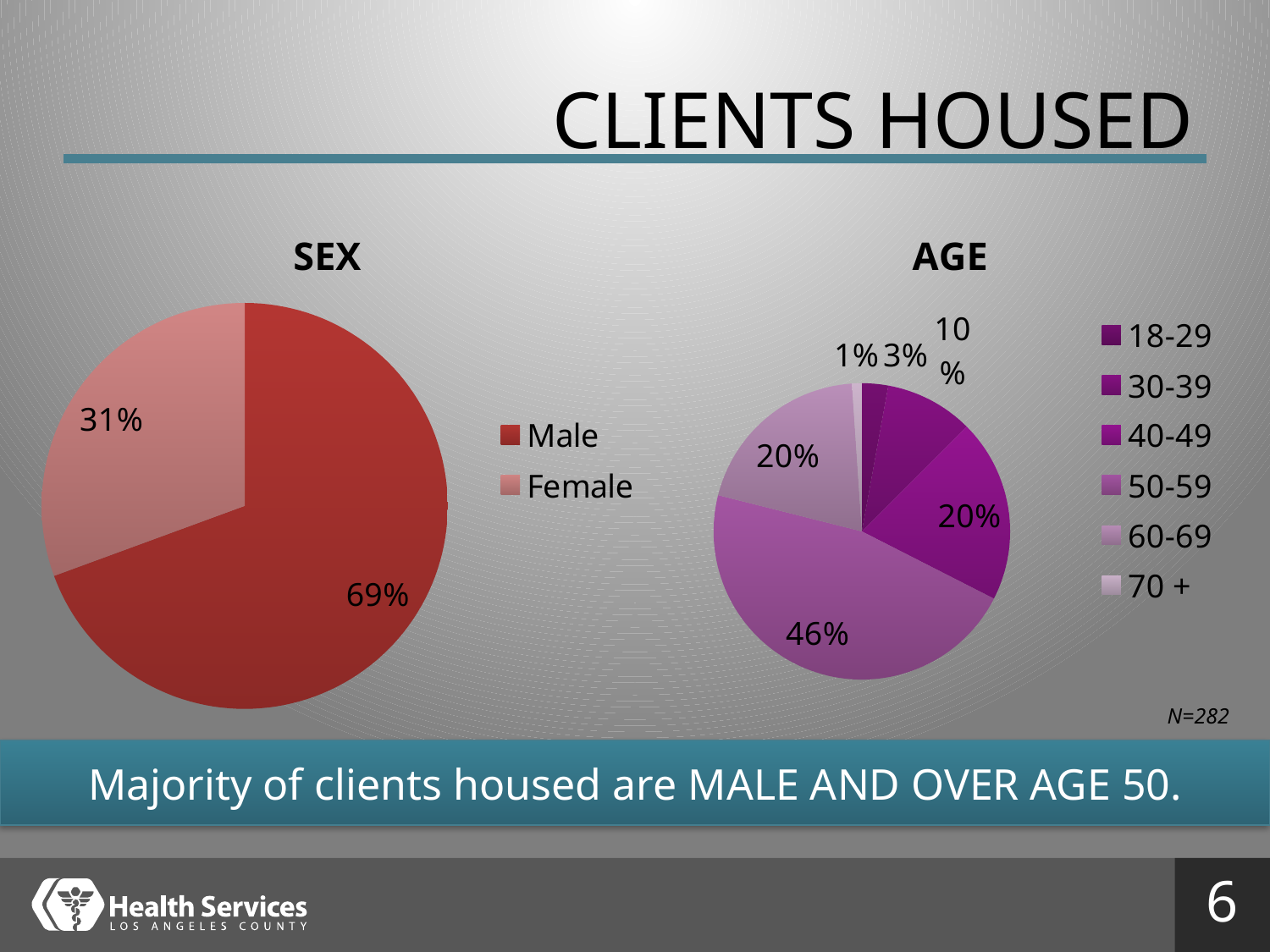
In the AGE chart, what percentage of clients housed are aged 50-59? 46% What is the sample size (N) shown on the slide? N=282 In the AGE chart, what percentage of clients housed are aged 30-39? 10% In the AGE chart, which age group has the largest share? 50-59 In the AGE chart, what is the difference between the 50-59 share and the 40-49 share? 26% In the SEX chart, which category has the larger share, Male or Female? Male What type of chart is the SEX chart? Pie chart In the SEX chart, what is the difference between the Male and Female percentages? 38% In the AGE chart, which age group has the smallest share? 70 + In the SEX chart, what percentage of clients housed are Female? 31% In the AGE chart, how many age groups are listed in the legend? 6 In the SEX chart, what percentage of clients housed are Male? 69%